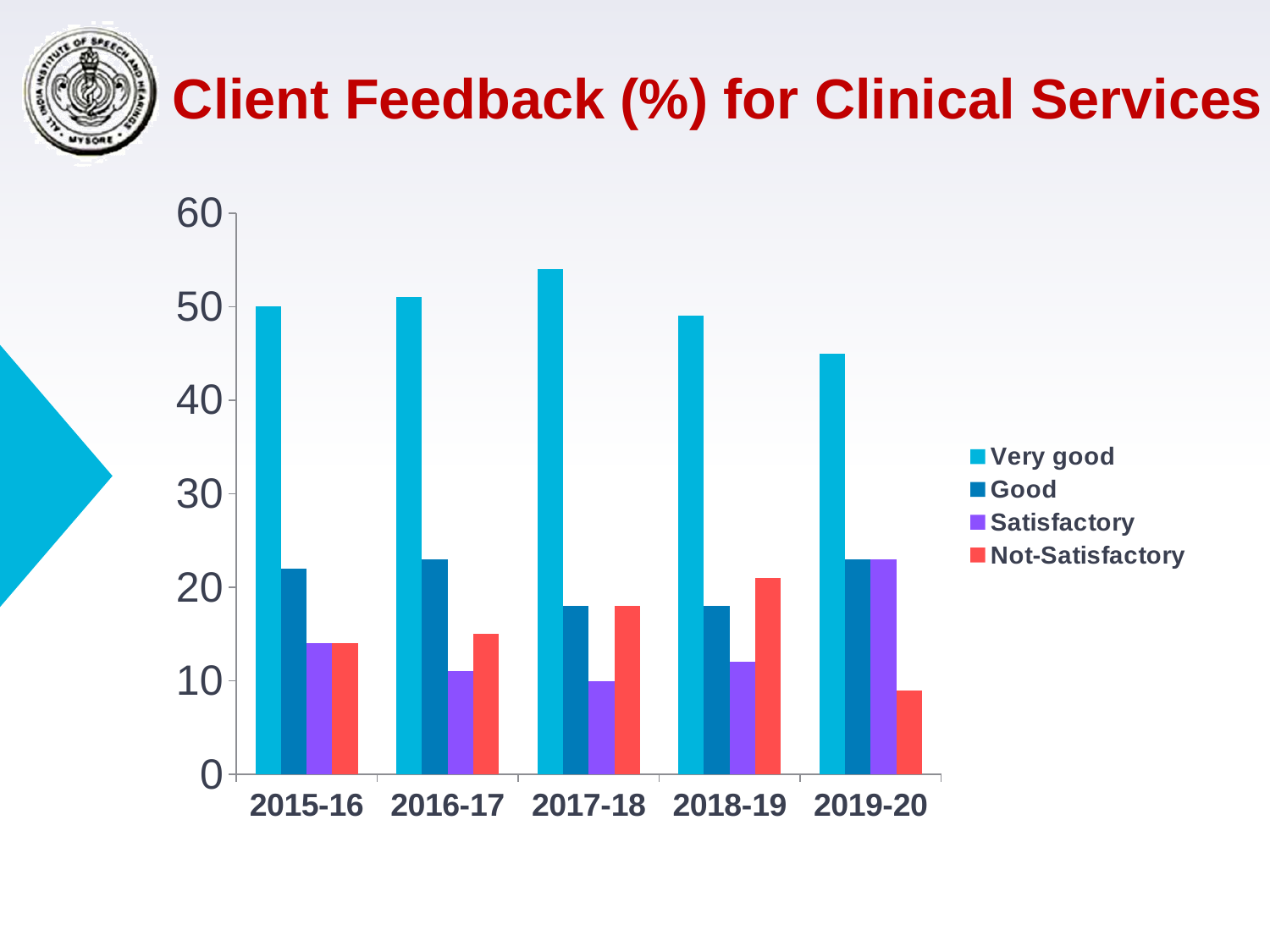
Is the Very good value for 2017-18 greater or less than 50? greater What is the title of the chart? Client Feedback (%) for Clinical Services In which year is the Very good value lowest? 2019-20 How many series does the legend list? 4 In which year is the Very good value highest? 2017-18 In which year is the Not-Satisfactory value highest? 2018-19 How many year categories are shown on the x axis? 5 What kind of chart is shown on the slide? Bar chart Is the Very good value for 2019-20 greater or less than 50? less In which year is the Not-Satisfactory value lowest? 2019-20 Which is larger in 2015-16, the Very good value or the Good value? Very good